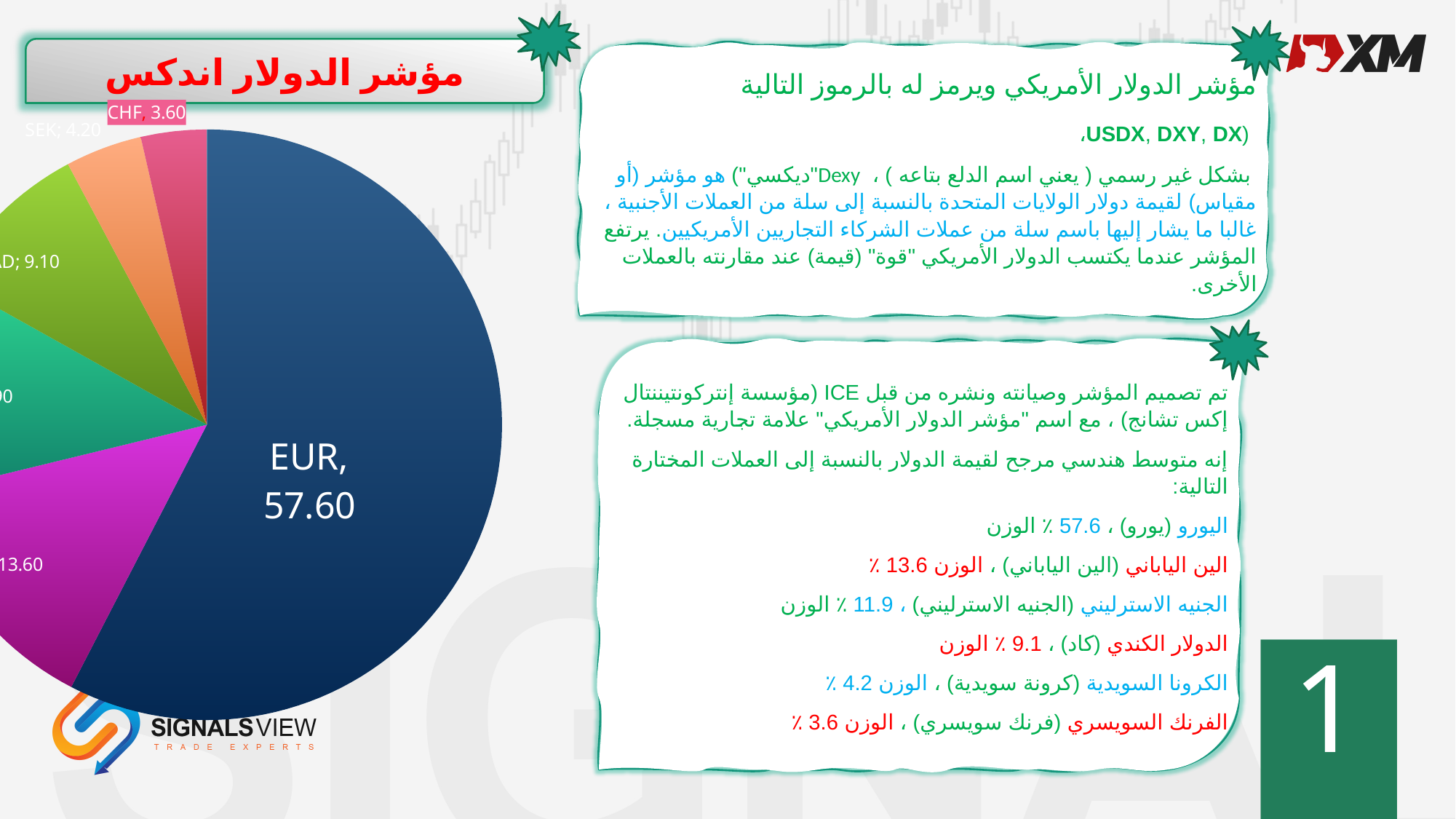
What is the difference between the EUR value and the CHF value in the pie chart? 54.00 What is the title shown above the pie chart? مؤشر الدولار اندكس What is the value shown for CHF in the pie chart? 3.60 What colour is the EUR slice in the pie chart? dark blue Which currency has the smallest slice in the pie chart? CHF What is the value shown for EUR in the pie chart? 57.60 What kind of chart is shown on the slide? pie chart Is the value for EUR in the pie chart greater or less than 50? greater What is the difference between the SEK value and the CHF value in the pie chart? 0.60 What is the value shown for SEK in the pie chart? 4.20 Which currency has the largest slice in the pie chart? EUR Which is larger in the pie chart, the value for SEK or the value for CHF? SEK